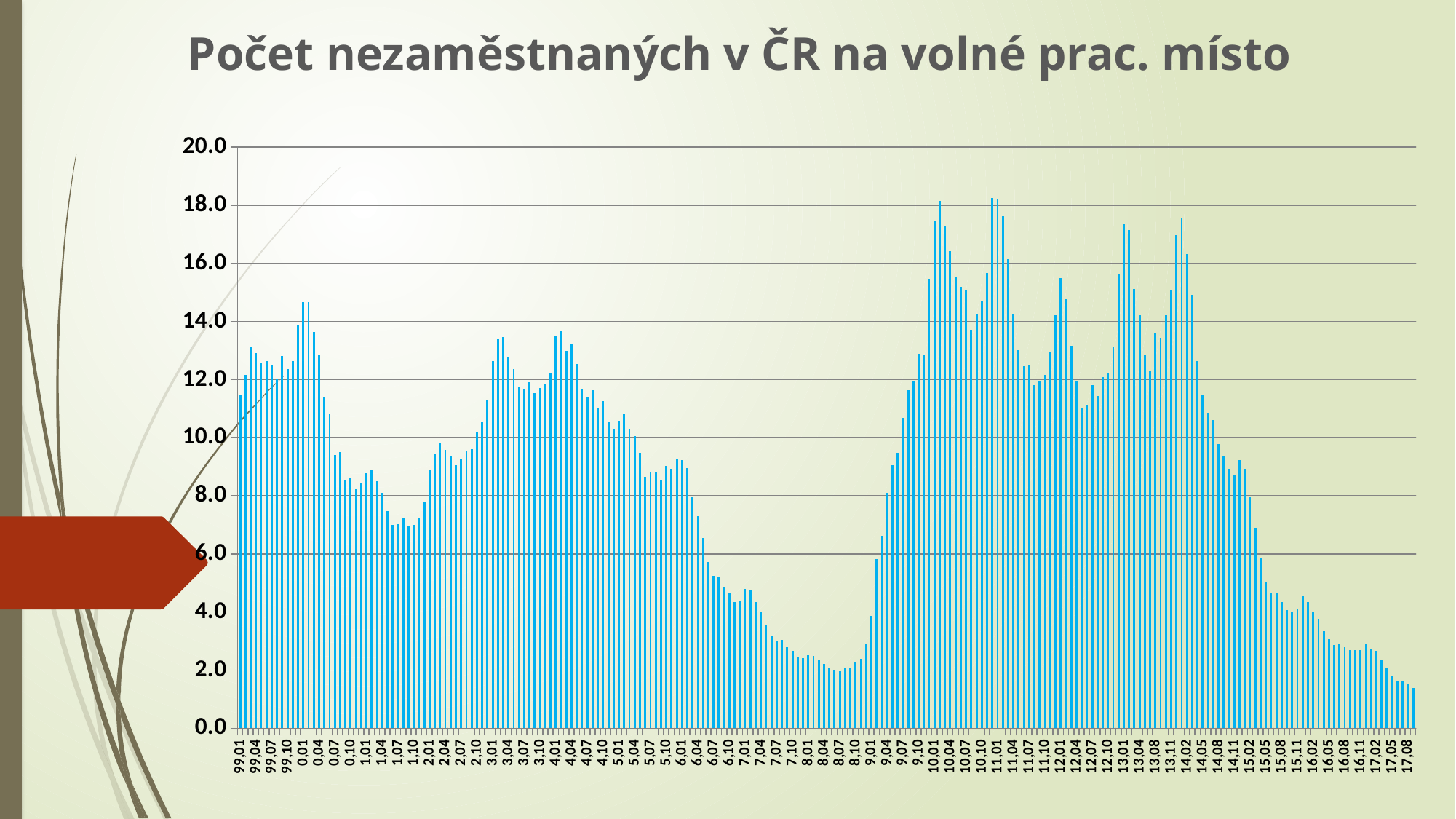
What type of chart is shown on the slide? bar chart Is the value for 99,01 greater or less than 10.0? greater Which has the larger value, 3,01 or 7,01? 3,01 Is the value for 10,01 greater or less than 16.0? greater Is the value for 17,08 greater or less than 2.0? less Which has the larger value, 10,01 or 99,01? 10,01 What is the title of the chart? Počet nezaměstnaných v ČR na volné prac. místo What is the highest value shown on the vertical axis? 20.0 Do the values rise or fall from 14,02 to 17,08? fall